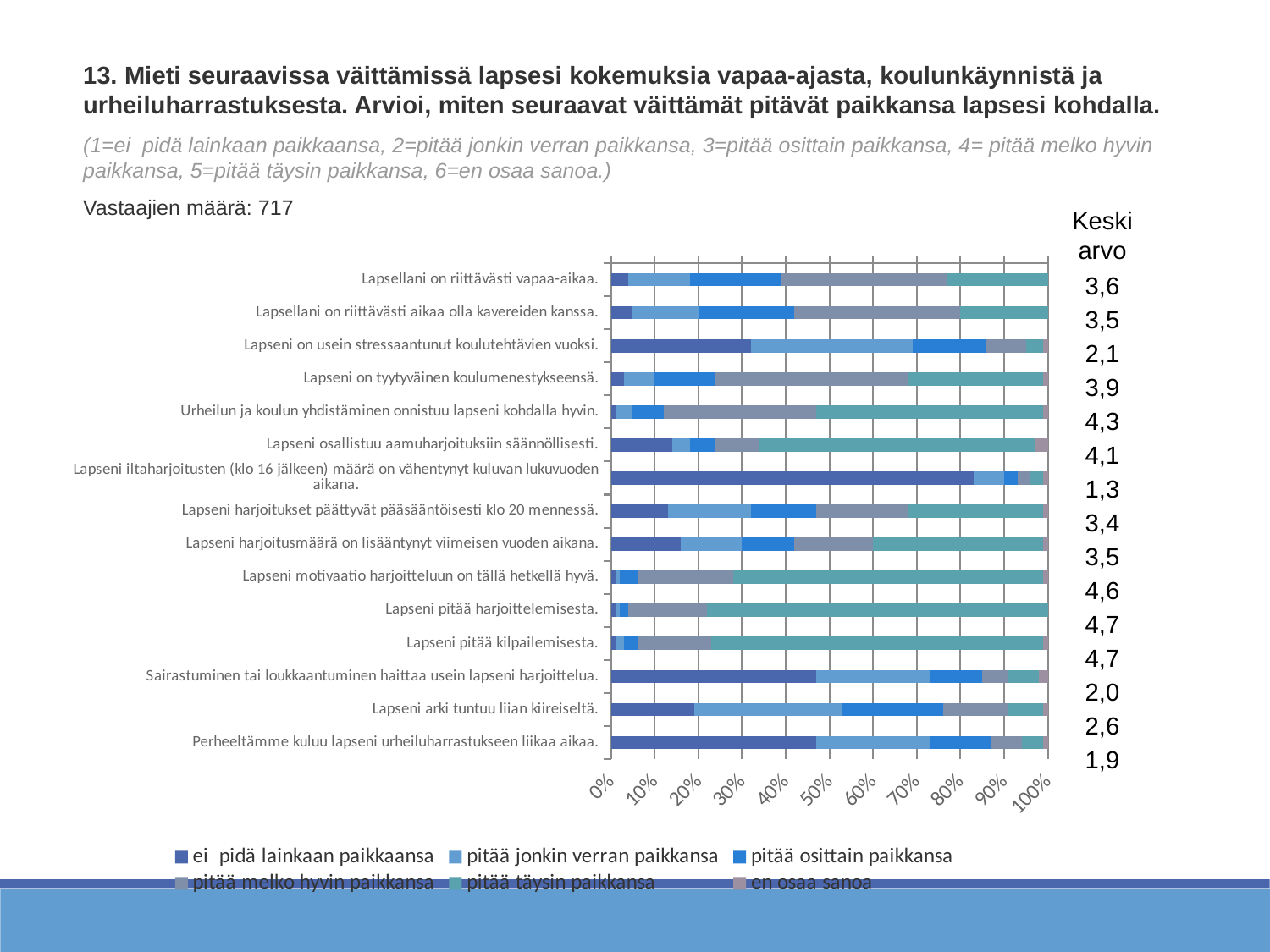
How many statements (categories) are plotted in the chart? 15 How many series does the legend list? 6 Which has a higher Keskiarvo value: "Urheilun ja koulun yhdistäminen onnistuu lapseni kohdalla hyvin." or "Lapseni on usein stressaantunut koulutehtävien vuoksi."? Urheilun ja koulun yhdistäminen onnistuu lapseni kohdalla hyvin. What is the Keskiarvo value shown for "Lapseni motivaatio harjoitteluun on tällä hetkellä hyvä."? 4,6 Which statement has the lowest Keskiarvo value? Lapseni iltaharjoitusten (klo 16 jälkeen) määrä on vähentynyt kuluvan lukuvuoden aikana. What is the Keskiarvo value shown for "Lapseni arki tuntuu liian kiireiseltä."? 2,6 What is the difference between the Keskiarvo values of "Urheilun ja koulun yhdistäminen onnistuu lapseni kohdalla hyvin." (4,3) and "Sairastuminen tai loukkaantuminen haittaa usein lapseni harjoittelua." (2,0)? 2,3 What is the Keskiarvo (mean) value shown for "Lapsellani on riittävästi vapaa-aikaa."? 3,6 What kind of chart is shown on the slide? bar chart Is the "ei pidä lainkaan paikkaansa" share for "Lapsellani on riittävästi vapaa-aikaa." greater or less than 10%? less How many respondents (Vastaajien määrä) does the slide report? 717 Is the "ei pidä lainkaan paikkaansa" share for "Lapseni on usein stressaantunut koulutehtävien vuoksi." greater or less than 30%? greater